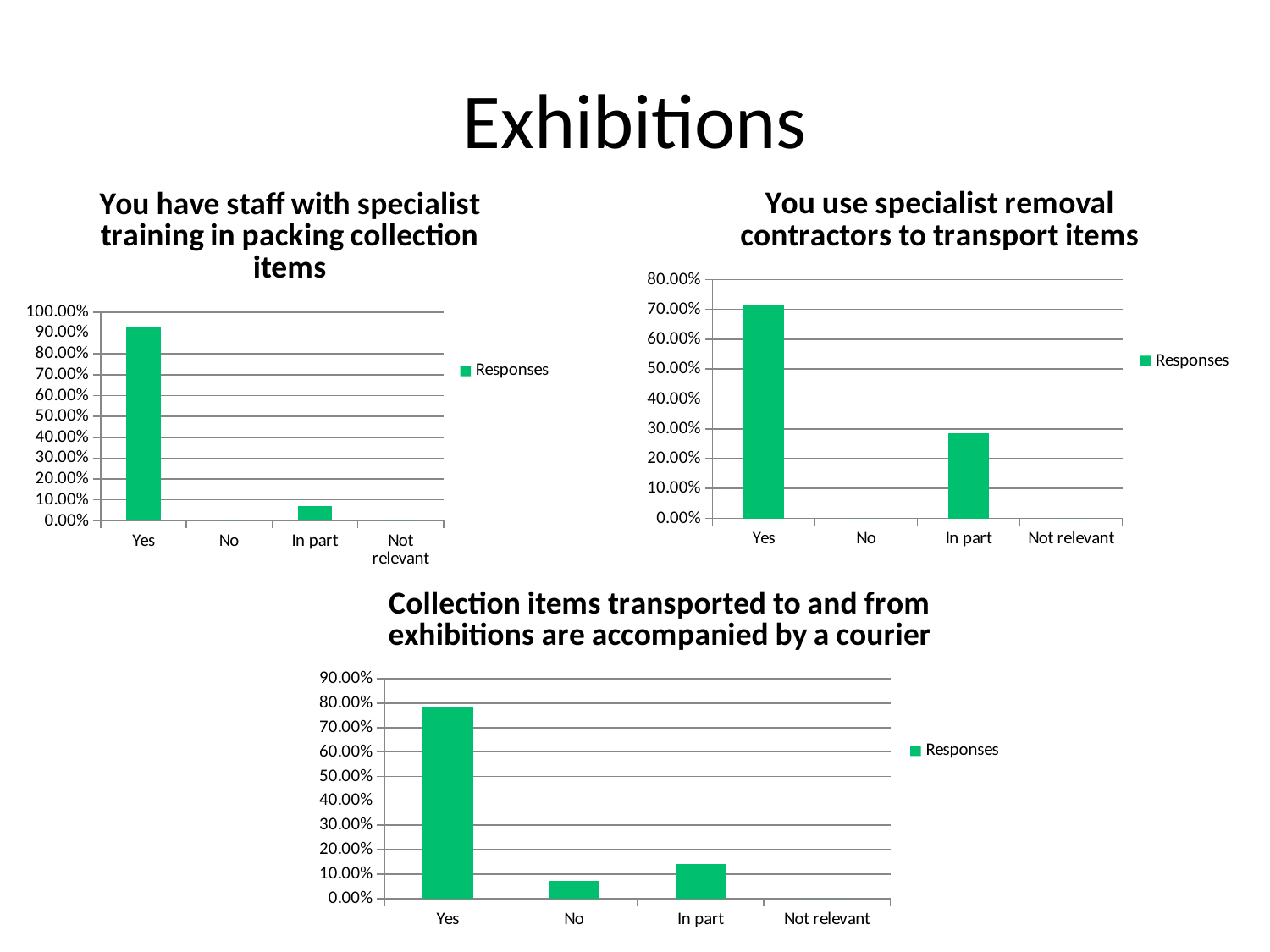
In the chart titled 'Collection items transported to and from exhibitions are accompanied by a courier', which category has the lowest value? Not relevant In the chart titled 'You use specialist removal contractors to transport items', is the value for Yes greater or less than 70.00%? greater In the chart titled 'Collection items transported to and from exhibitions are accompanied by a courier', which category has the highest value? Yes In the chart titled 'Collection items transported to and from exhibitions are accompanied by a courier', which is larger, No or In part? In part In the chart titled 'Collection items transported to and from exhibitions are accompanied by a courier', is the value for Yes greater or less than 70.00%? greater In the chart titled 'You have staff with specialist training in packing collection items', which category has the highest value? Yes How many categories are shown on the x axis of the chart titled 'You use specialist removal contractors to transport items'? 4 In the chart titled 'You have staff with specialist training in packing collection items', is the value for In part greater or less than 10.00%? less In the chart titled 'You use specialist removal contractors to transport items', which is larger, Yes or In part? Yes What type of chart is the chart titled 'Collection items transported to and from exhibitions are accompanied by a courier'? Bar chart